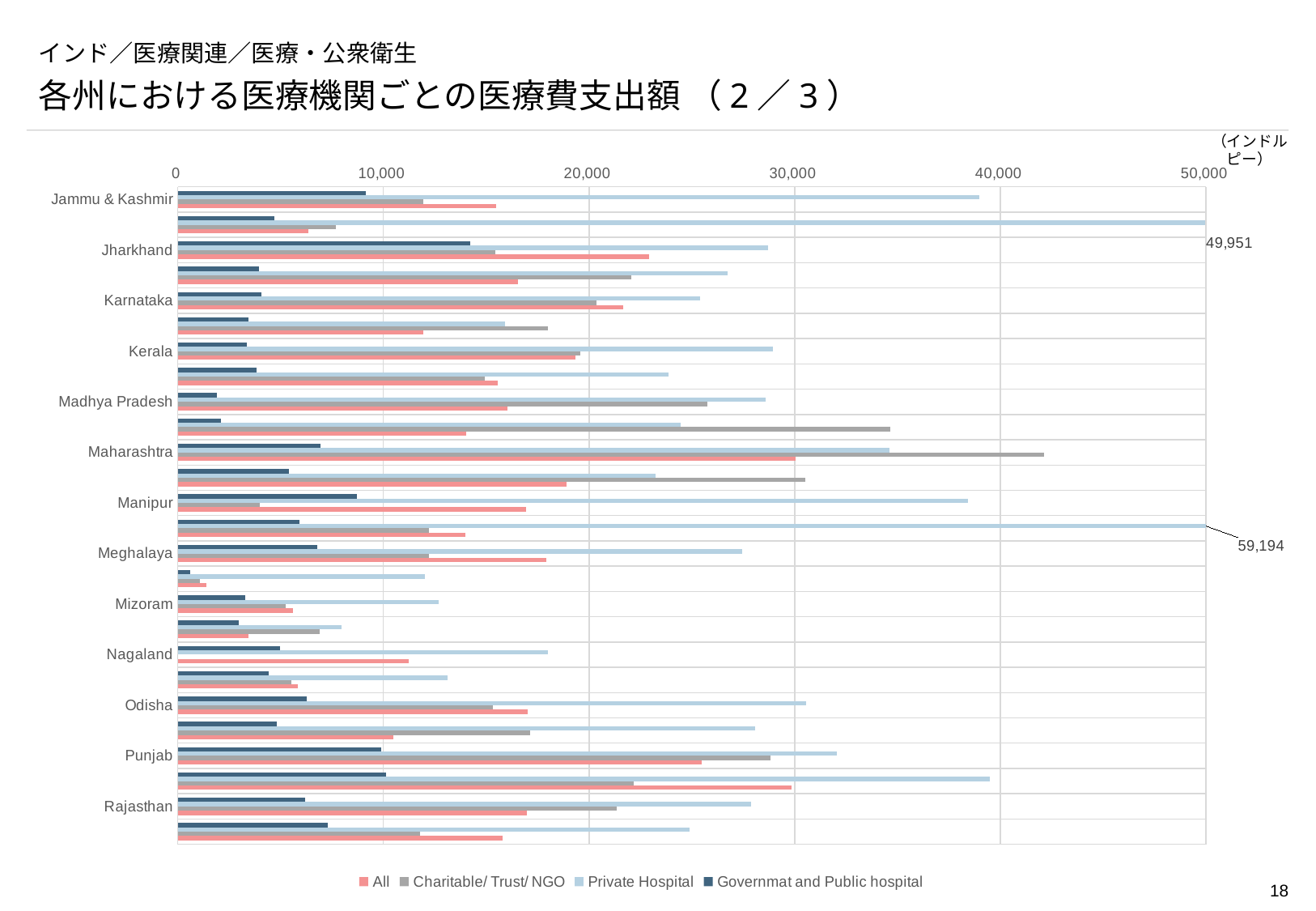
Is the Governmat and Public hospital value for Kerala greater or less than 10,000? less What are the series names listed in the legend? All, Charitable/ Trust/ NGO, Private Hospital, Governmat and Public hospital For Maharashtra, which is larger: the Charitable/ Trust/ NGO value or the Private Hospital value? Charitable/ Trust/ NGO Is the Private Hospital value for Jammu & Kashmir greater or less than 30,000? greater Which is larger: the All value for Nagaland or the All value for Mizoram? Nagaland What is the largest value printed as a data label on the chart? 59,194 What kind of chart is shown on the slide? bar chart Is the Private Hospital value for Punjab greater or less than 30,000? greater What is the maximum value shown on the horizontal axis? 50,000 How many series does the legend list? 4